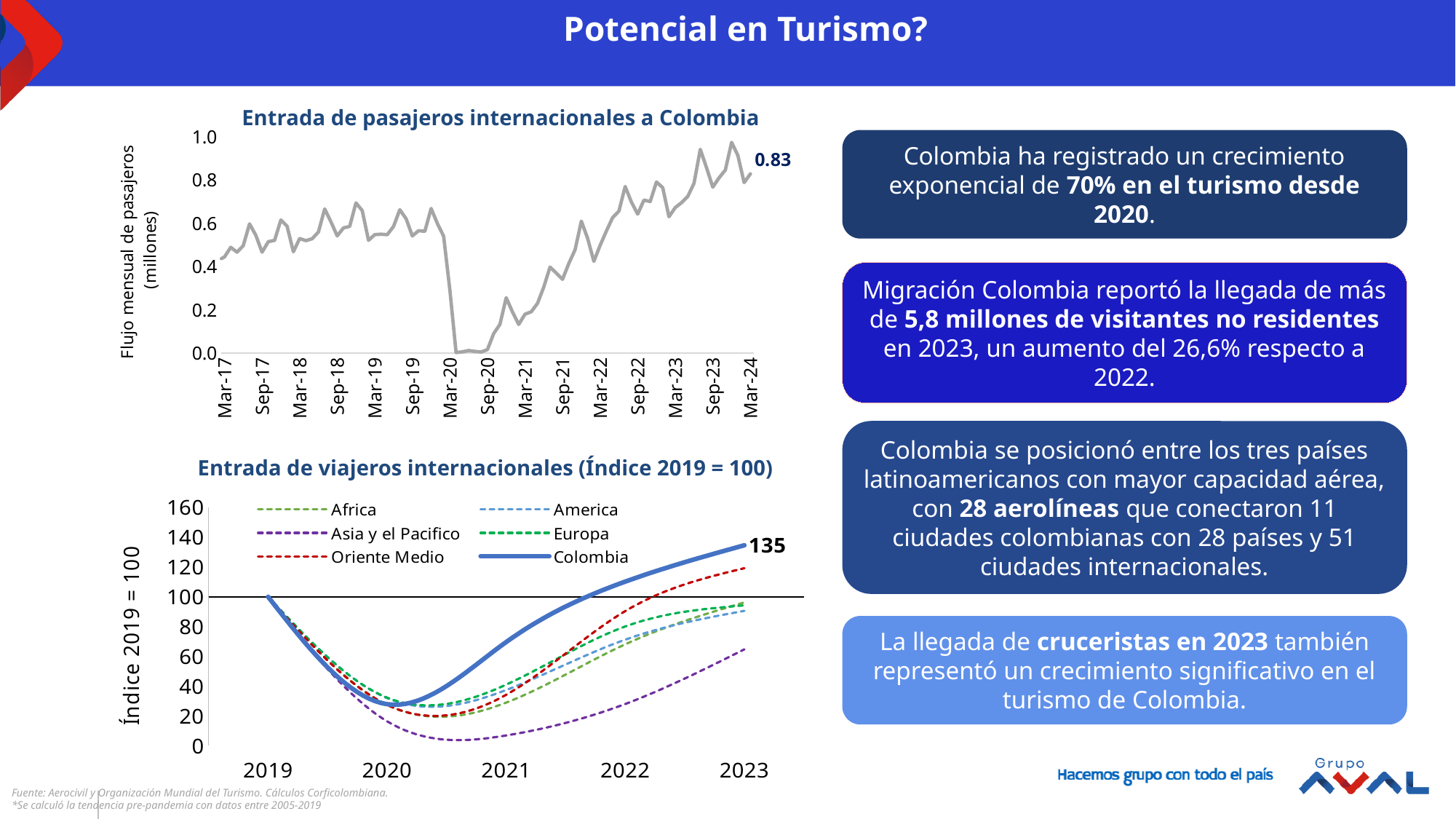
In the top chart 'Entrada de pasajeros internacionales a Colombia', do values generally rise or fall from Sep-20 to Mar-24? rise In the bottom chart 'Entrada de viajeros internacionales (Índice 2019 = 100)', which is larger at 2023: Colombia or Oriente Medio? Colombia In the bottom chart 'Entrada de viajeros internacionales (Índice 2019 = 100)', what value is labelled for Colombia at 2023? 135 What kind of chart is the top chart, 'Entrada de pasajeros internacionales a Colombia'? line chart In the bottom chart 'Entrada de viajeros internacionales (Índice 2019 = 100)', is the value for Oriente Medio at 2023 greater or less than 100? greater In the bottom chart 'Entrada de viajeros internacionales (Índice 2019 = 100)', which series is highest at 2023? Colombia What is the title of the top chart on the slide? Entrada de pasajeros internacionales a Colombia In the bottom chart 'Entrada de viajeros internacionales (Índice 2019 = 100)', is the value for Asia y el Pacifico at 2023 greater or less than 80? less In the top chart 'Entrada de pasajeros internacionales a Colombia', is the value at Sep-20 greater or less than 0.2? less In the bottom chart 'Entrada de viajeros internacionales (Índice 2019 = 100)', which series is lowest at 2023? Asia y el Pacifico In the top chart 'Entrada de pasajeros internacionales a Colombia', what value is labelled at Mar-24? 0.83 How many series does the legend of the bottom chart 'Entrada de viajeros internacionales (Índice 2019 = 100)' list? 6